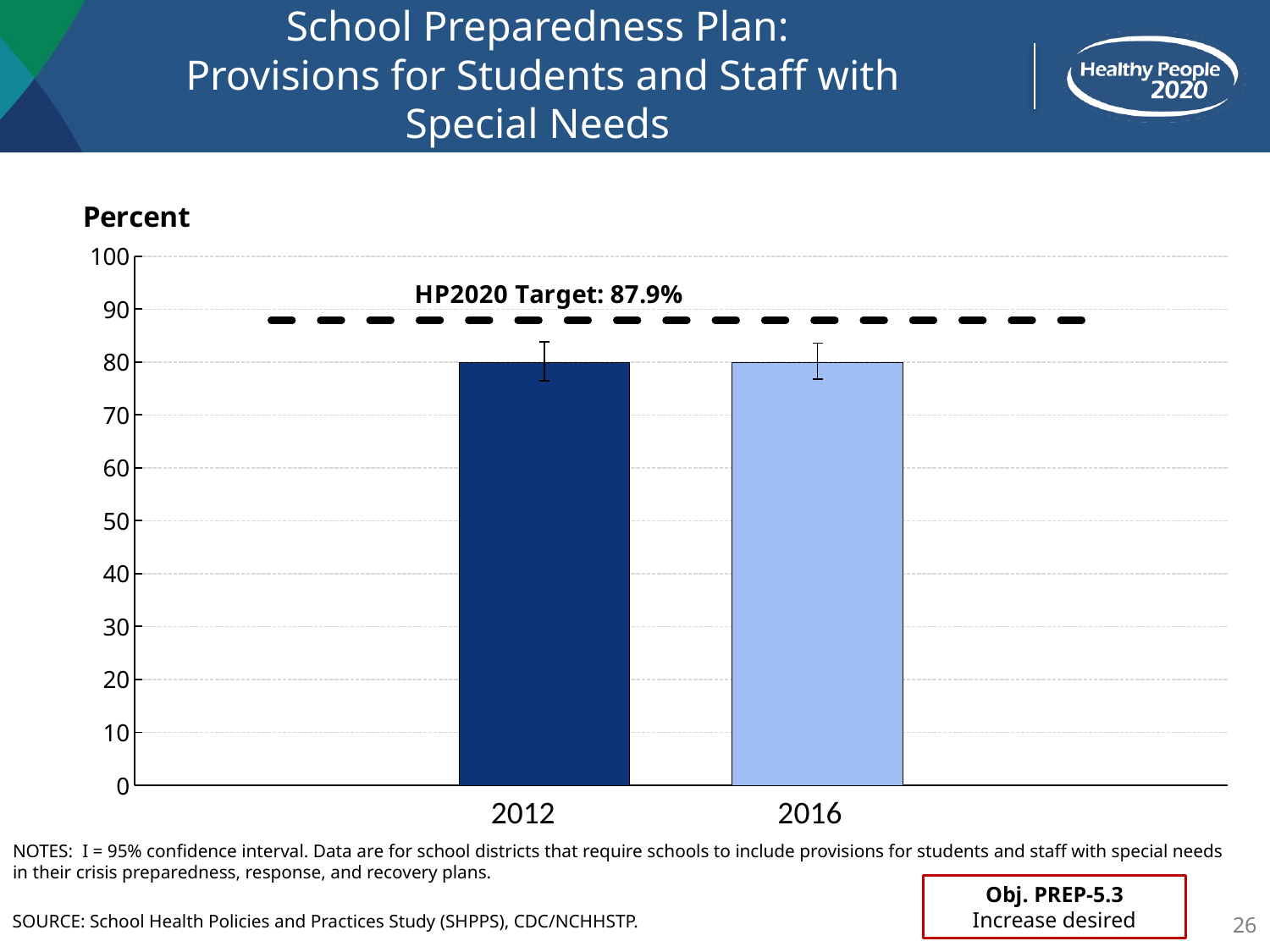
What is the HP2020 Target value shown by the dashed line? 87.9% What is the maximum value shown on the vertical axis? 100 Is the value for 2012 greater or less than 70? greater How many years (categories) are plotted on the x axis? 2 Is the value for 2016 greater or less than 90? less Is the value for 2016 greater or less than 60? greater What is the label of the vertical axis? Percent What kind of chart is shown on the slide? bar chart Which two years are shown on the x axis? 2012 and 2016